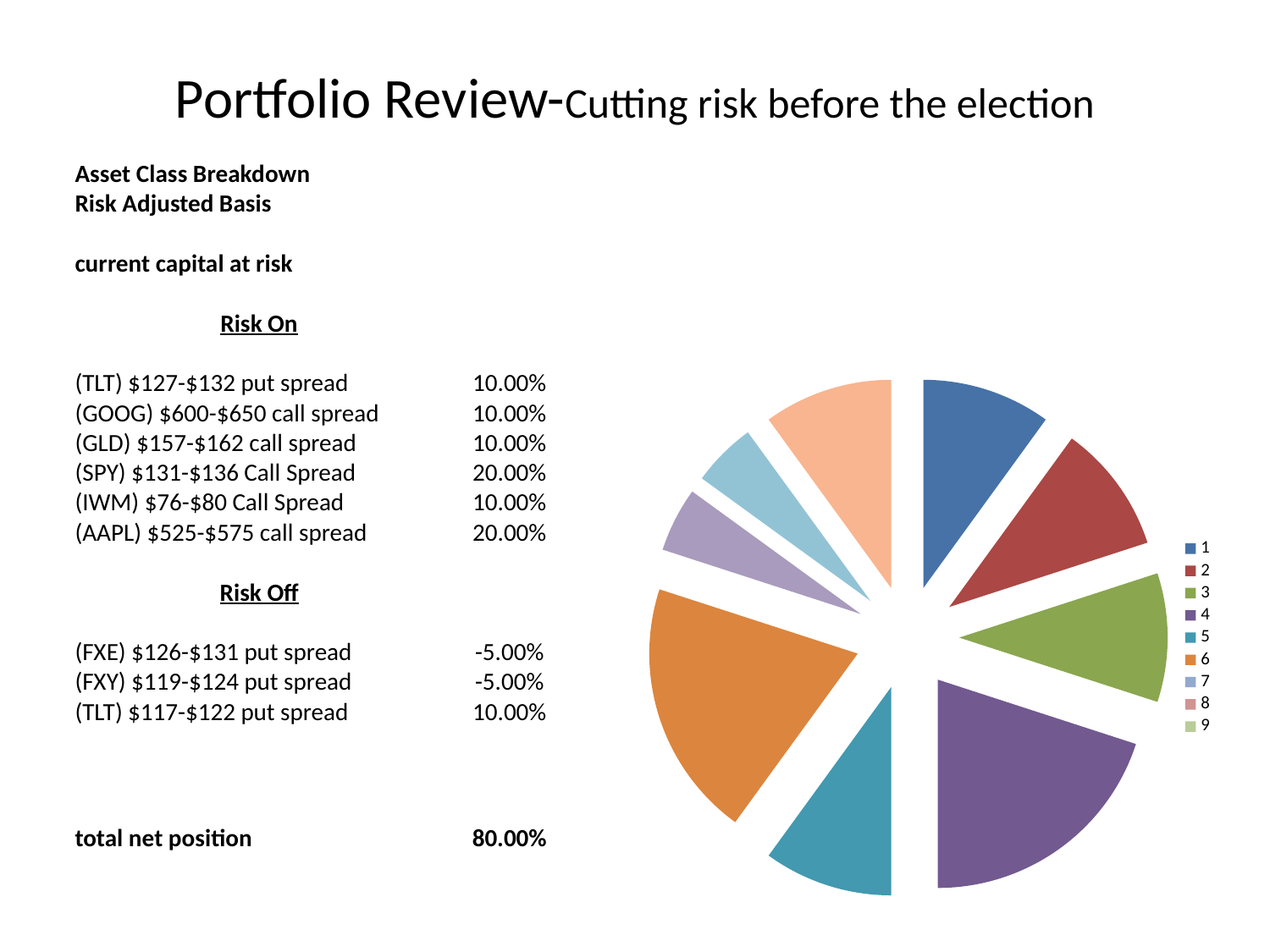
In the pie chart, which is larger, slice 1 or slice 7? 1 How many entries does the legend of the pie chart list? 9 How many slices does the pie chart have? 9 What colour is slice 1 in the pie chart? blue What kind of chart is shown on the slide? pie chart What colour is slice 6 in the pie chart? orange In the pie chart, which is larger, slice 4 or slice 9? 4 In the pie chart, which is larger, slice 4 or slice 1? 4